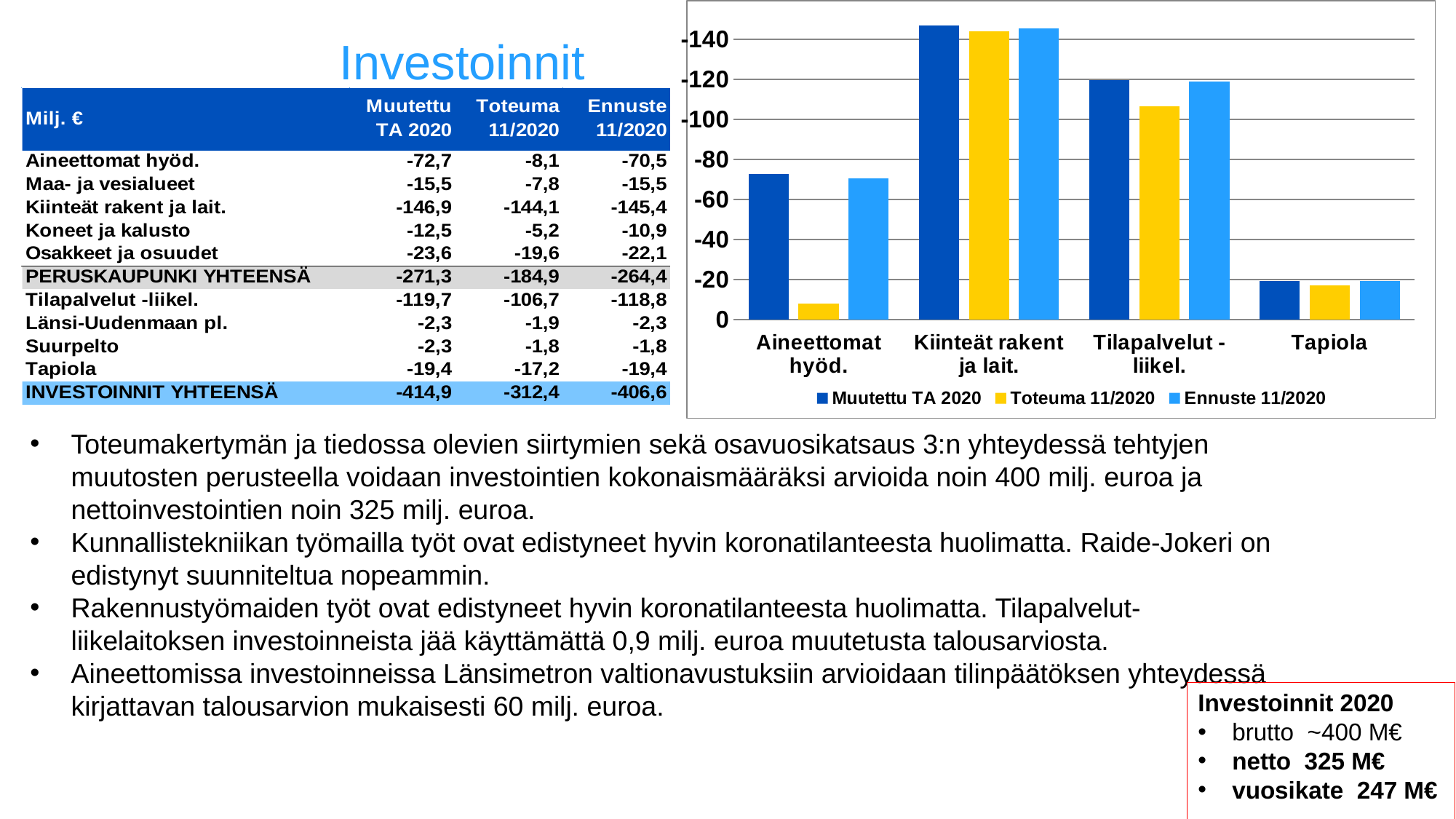
Which category has the tallest bars in the chart? Kiinteät rakent ja lait. How many series does the chart legend list? 3 Which series is shown in yellow in the chart? Toteuma 11/2020 Which category has the shortest bars in the chart? Tapiola According to the table, what is the Toteuma 11/2020 value for Tapiola? -17,2 For Aineettomat hyöd., which bar is taller: Muutettu TA 2020 or Toteuma 11/2020? Muutettu TA 2020 Using the table values, what is the difference between Muutettu TA 2020 (-119,7) and Ennuste 11/2020 (-118,8) for Tilapalvelut -liikel.? 0,9 Does the Toteuma 11/2020 bar for Aineettomat hyöd. reach the -20 gridline? No For Tilapalvelut -liikel., which bar is taller: Toteuma 11/2020 or Ennuste 11/2020? Ennuste 11/2020 What type of chart is shown on the right side of the slide? Bar chart How many categories are shown on the x axis of the chart? 4 According to the table on the slide, what is the Muutettu TA 2020 value for Kiinteät rakent ja lait.? -146,9